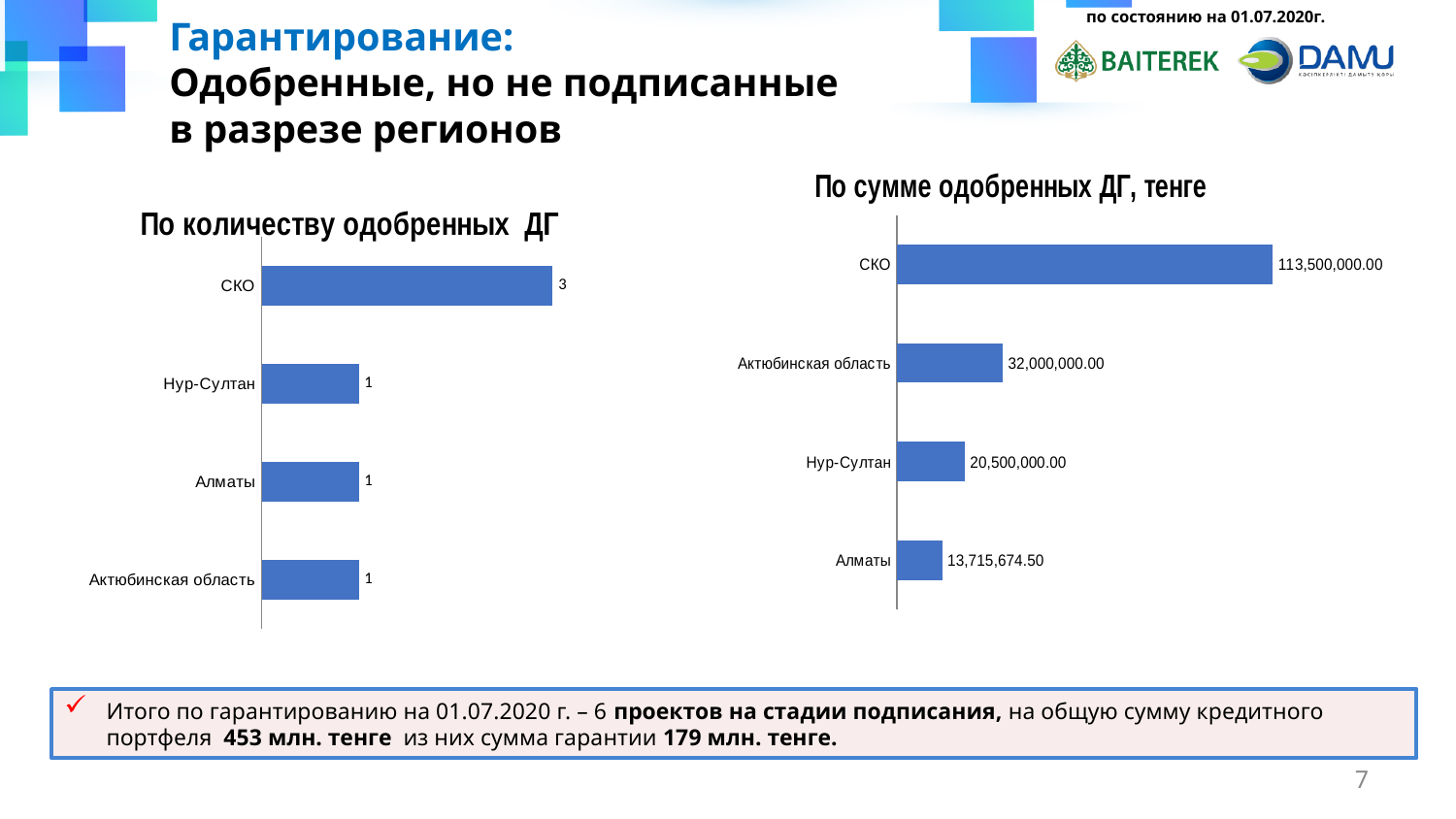
In the chart 'По количеству одобренных ДГ', what is the difference between СКО and Нур-Султан? 2 In the chart 'По сумме одобренных ДГ, тенге', what is the value for Алматы? 13,715,674.50 In the chart 'По количеству одобренных ДГ', how many regions are shown? 4 In the chart 'По количеству одобренных ДГ', which region has the highest value? СКО In the chart 'По сумме одобренных ДГ, тенге', which region has the lowest value? Алматы In the chart 'По сумме одобренных ДГ, тенге', what is the difference between СКО and Нур-Султан? 93,000,000.00 In the chart 'По сумме одобренных ДГ, тенге', which region has the highest value? СКО What type of chart is 'По сумме одобренных ДГ, тенге'? Bar chart In the chart 'По количеству одобренных ДГ', what is the value for СКО? 3 What is the title of the chart on the left side of the slide? По количеству одобренных ДГ In the chart 'По сумме одобренных ДГ, тенге', which is larger: Нур-Султан or Актюбинская область? Актюбинская область In the chart 'По сумме одобренных ДГ, тенге', what is the value for Актюбинская область? 32,000,000.00